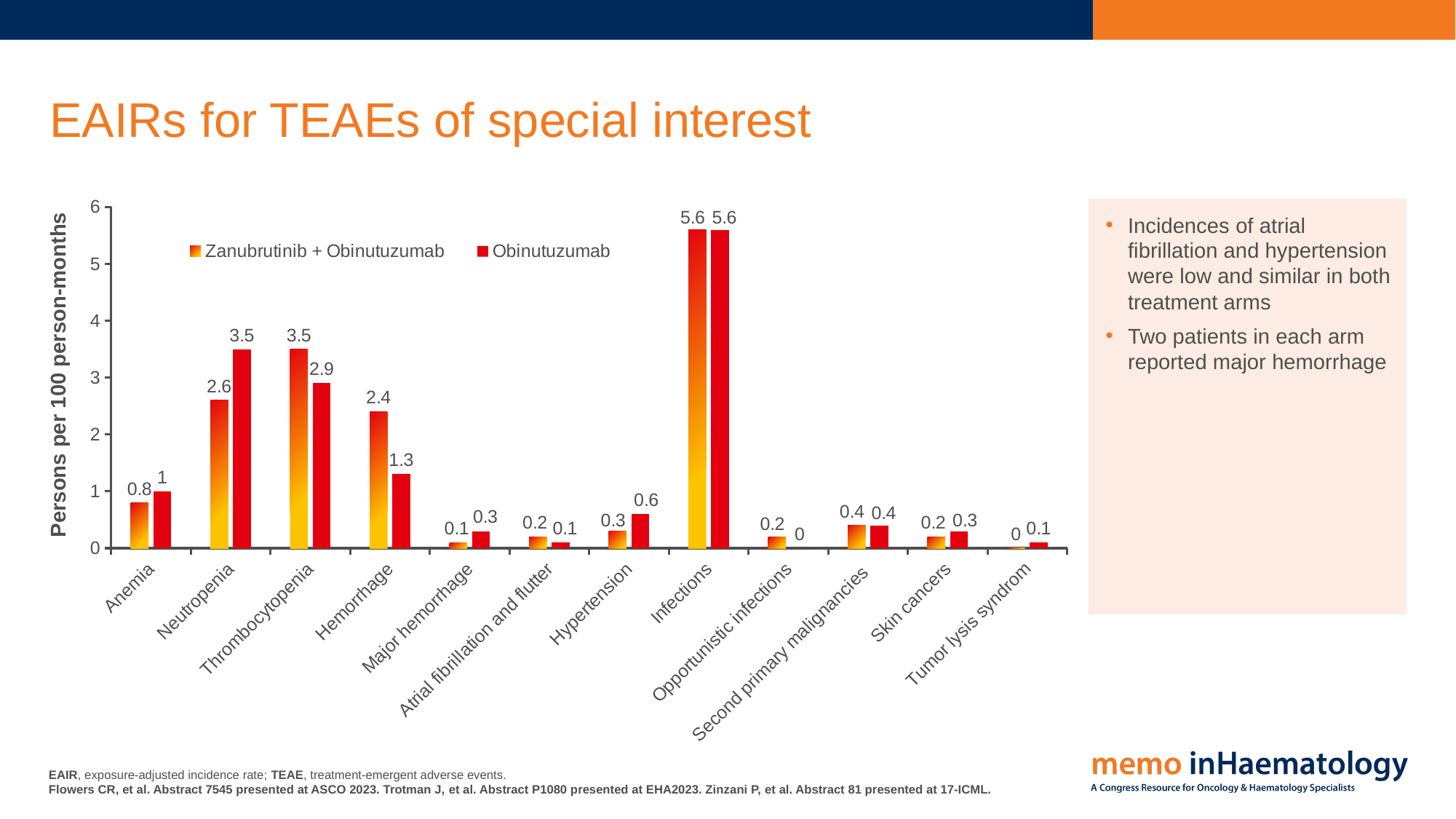
How many series does the legend list? 2 How many categories are shown on the x axis? 12 Which category has the highest value for the Obinutuzumab series? Infections What is the value for Obinutuzumab for Hypertension? 0.6 For Thrombocytopenia, which series has the larger value, Zanubrutinib + Obinutuzumab or Obinutuzumab? Zanubrutinib + Obinutuzumab Which category has the lowest value for the Zanubrutinib + Obinutuzumab series? Tumor lysis syndrom What kind of chart is shown on the slide? Bar chart What is the value for Zanubrutinib + Obinutuzumab for Neutropenia? 2.6 What is the difference between the Zanubrutinib + Obinutuzumab and Obinutuzumab values for Hemorrhage? 1.1 Is the value for Obinutuzumab for Neutropenia greater or less than 3? greater What is the y-axis label of the chart? Persons per 100 person-months What is the value for Obinutuzumab for Hemorrhage? 1.3